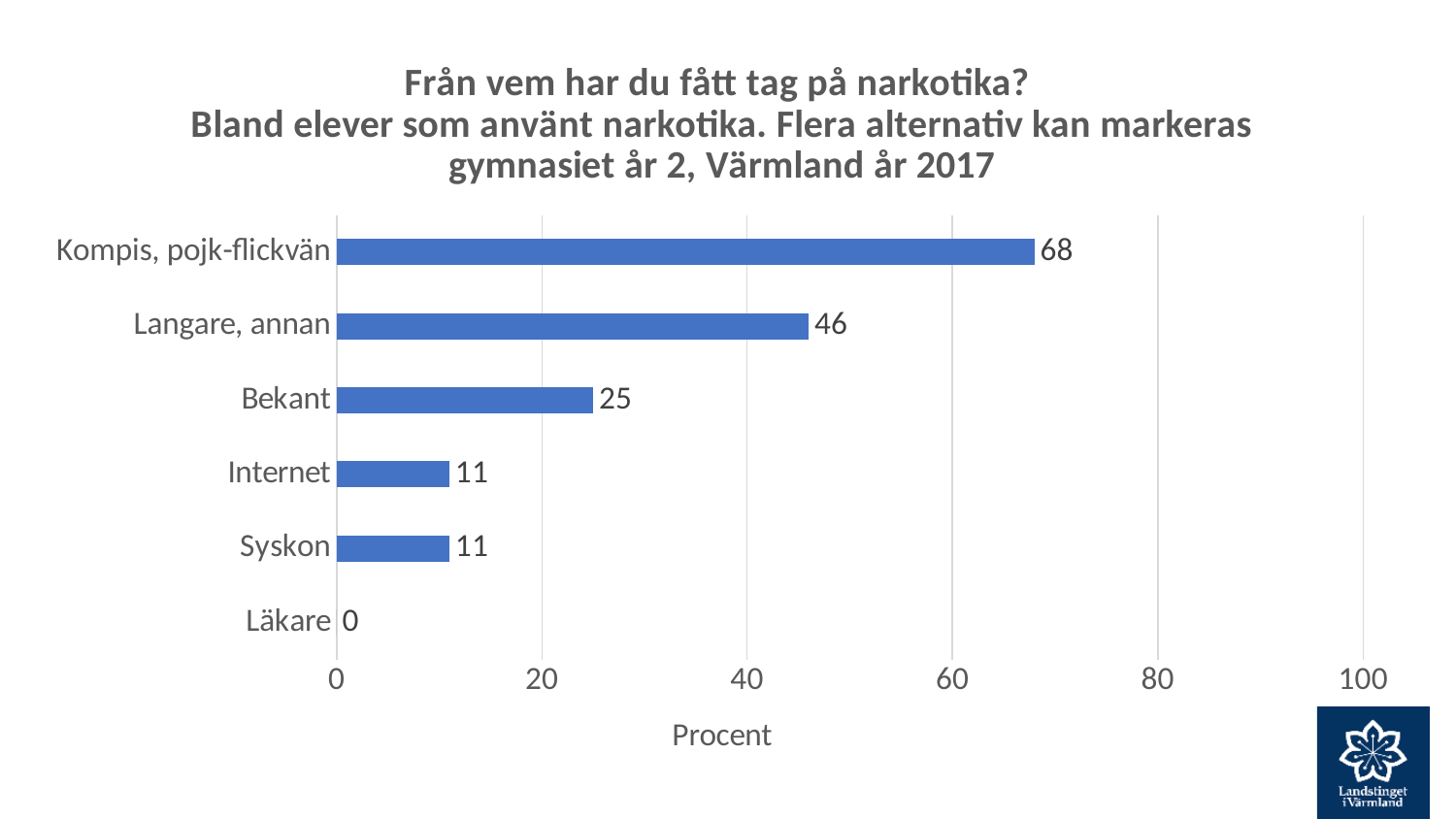
What is the value for Kompis, pojk-flickvän? 68 Which category has the highest value? Kompis, pojk-flickvän What is the value for Läkare? 0 What is the value for Bekant? 25 What is the difference between the values for Bekant and Internet? 14 Which is larger, the value for Langare, annan or the value for Bekant? Langare, annan What is the value for Langare, annan? 46 What is the difference between the values for Kompis, pojk-flickvän and Langare, annan? 22 How many categories are shown in the chart? 6 What kind of chart is shown on the slide? Bar chart What is the label of the horizontal axis? Procent Which category has the lowest value? Läkare